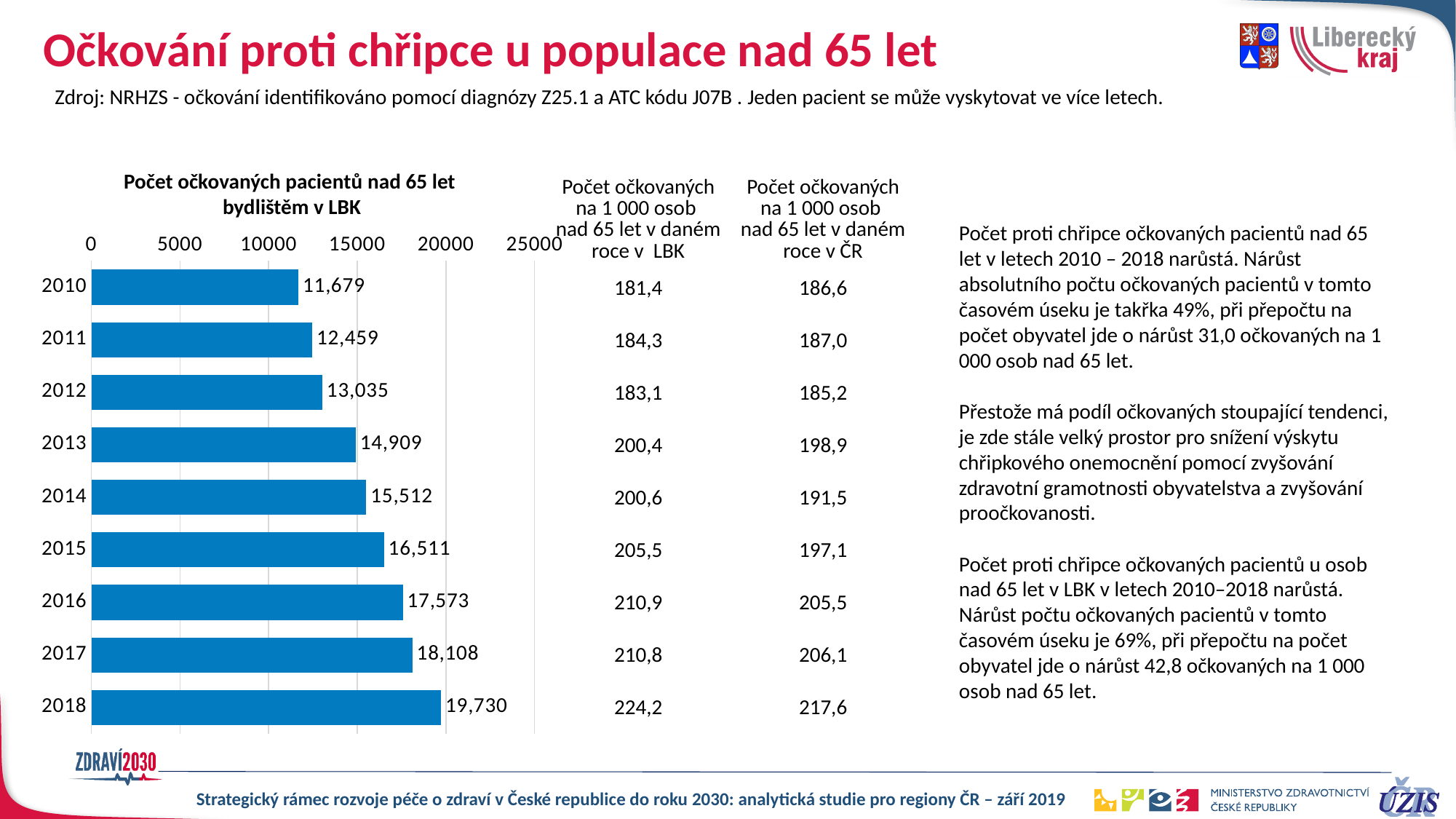
What kind of chart is shown on the slide? bar chart Which year has the highest value in the chart? 2018 What is the difference between the values for 2014 and 2013? 603 What is the difference between the values for 2018 and 2010? 8,051 What is the value for 2010 in the chart? 11,679 What is the value for 2015 in the chart? 16,511 What is the value for 2018 in the chart? 19,730 Which year has the lowest value in the chart? 2010 Do the values rise or fall from 2010 to 2018? rise How many years are shown in the chart? 9 Is the value for 2017 greater or less than 15000? greater Which is larger, the value for 2016 or the value for 2012? 2016